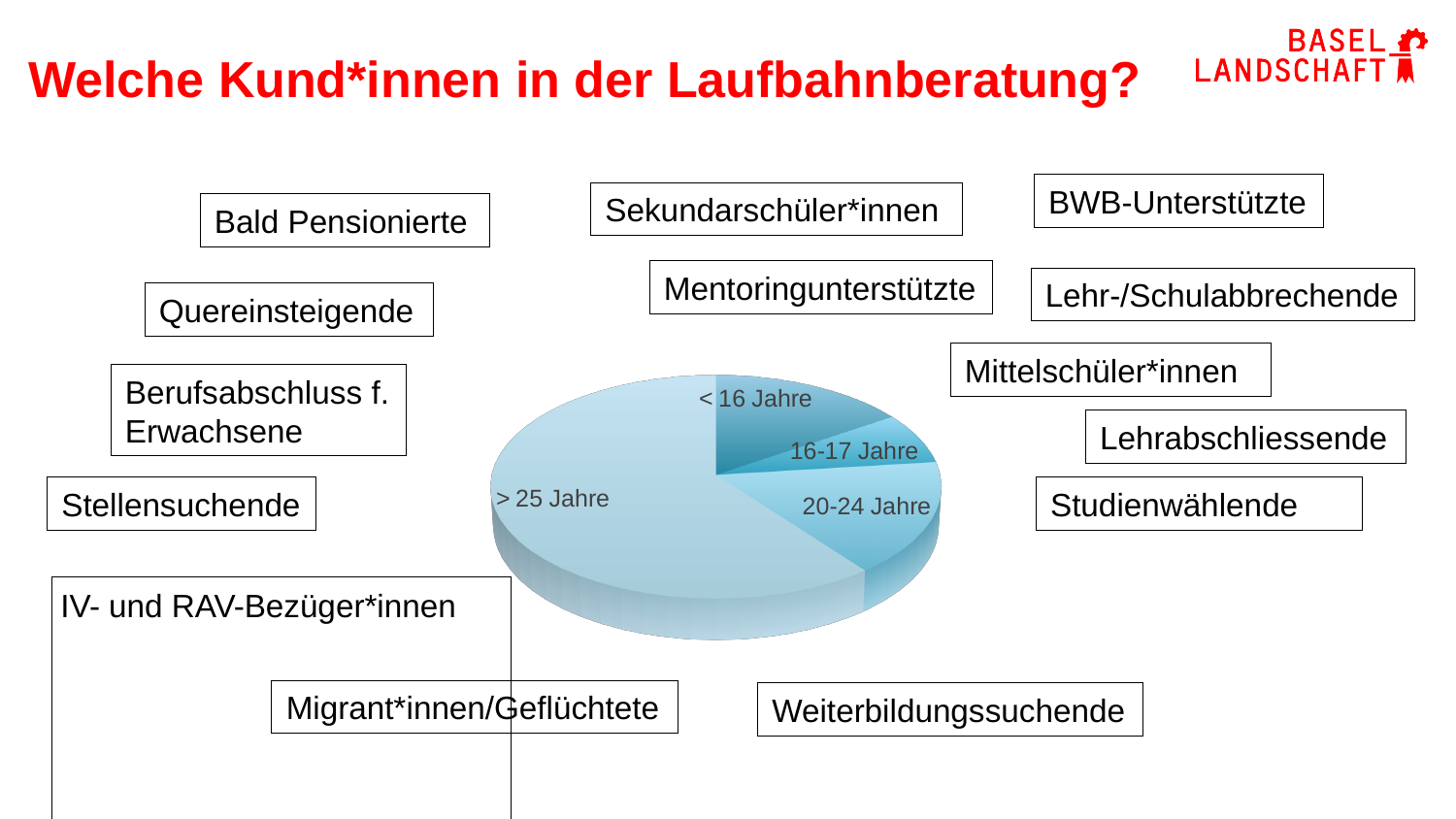
How many slices does the pie chart have? 4 Which slice of the pie chart is the largest? > 25 Jahre What kind of chart is shown on the slide? pie chart What is the title of the slide containing the pie chart? Welche Kund*innen in der Laufbahnberatung? Does the "> 25 Jahre" slice make up more or less than half of the pie chart? more What are the labels of the four slices in the pie chart? < 16 Jahre, 16-17 Jahre, 20-24 Jahre, > 25 Jahre Which slice is larger in the pie chart, "20-24 Jahre" or "16-17 Jahre"? 20-24 Jahre Does the "< 16 Jahre" slice make up more or less than a quarter of the pie chart? less Which slice is larger in the pie chart, "> 25 Jahre" or "20-24 Jahre"? > 25 Jahre